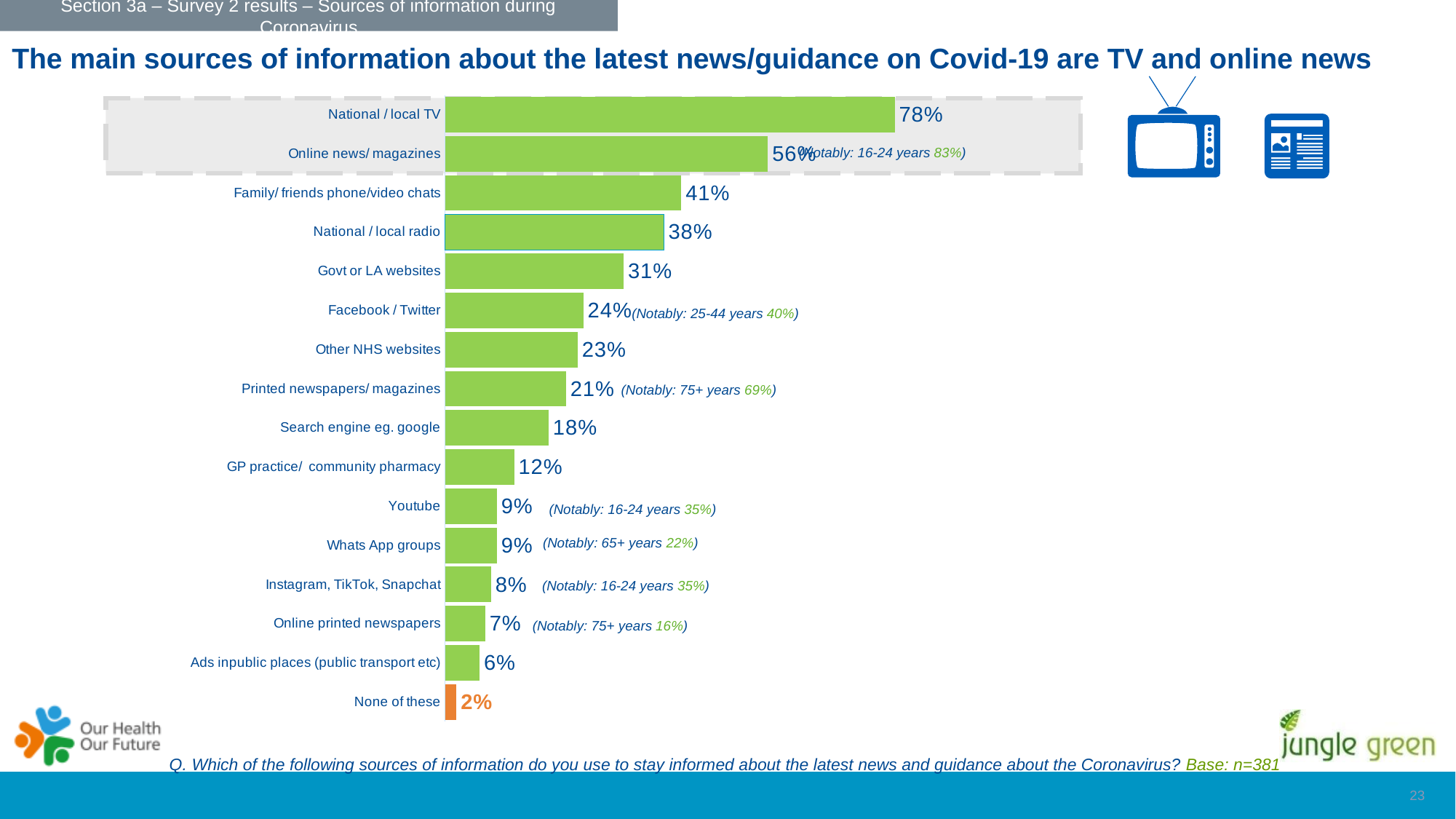
What type of chart is shown on the slide? Bar chart What percentage is shown for Search engine eg. google? 18% What is the difference between the percentages for Facebook / Twitter and Other NHS websites? 1% What is the difference between the percentages for National / local TV and Online news/ magazines? 22% Which source of information has the highest percentage? National / local TV How many categories are shown on the chart? 16 What percentage of respondents use National / local TV as a source of information? 78% Which has a higher percentage: Family/ friends phone/video chats or National / local radio? Family/ friends phone/video chats What is the value shown for Ads in public places (public transport etc)? 6% What is the value shown for Govt or LA websites? 31% Which bar on the chart is coloured orange rather than green? None of these Which category has the lowest percentage on the chart? None of these